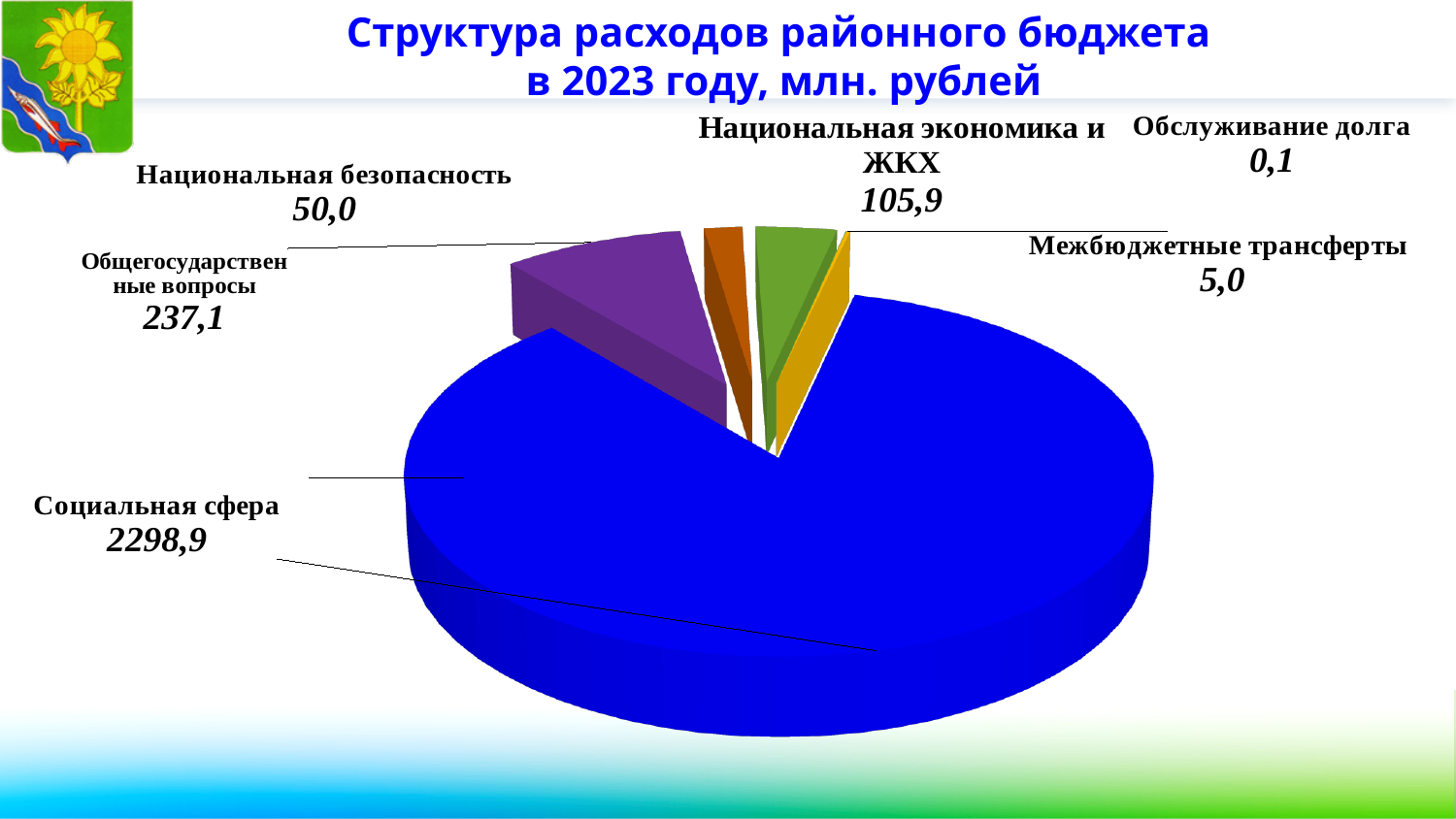
What is the title of the chart? Структура расходов районного бюджета в 2023 году, млн. рублей Which category has the smallest value? Обслуживание долга What is the value for Социальная сфера? 2298,9 What is the difference between Национальная экономика и ЖКХ and Национальная безопасность? 55,9 How many categories are shown in the chart? 6 Which is larger: Национальная безопасность or Межбюджетные трансферты? Национальная безопасность What is the value for Обслуживание долга? 0,1 What is the value for Общегосударственные вопросы? 237,1 What is the difference between Социальная сфера and Общегосударственные вопросы? 2061,8 What kind of chart is shown on the slide? Pie chart What is the value for Национальная экономика и ЖКХ? 105,9 Which category has the largest value? Социальная сфера